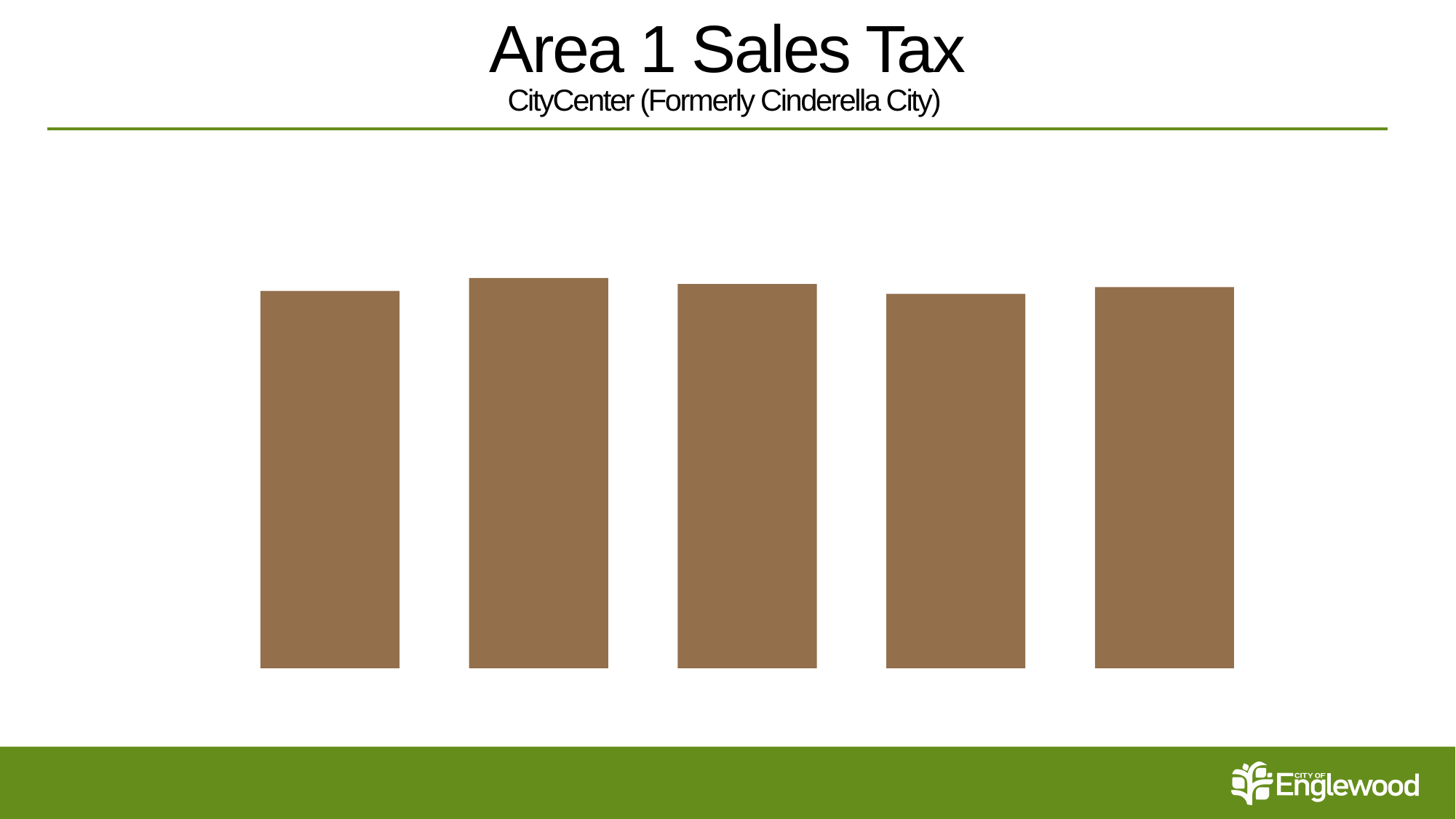
How many bars does the chart show? 5 Which bar is taller, the second bar from the left or the fourth bar from the left? the second bar from the left What colour are the bars in the chart? brown What kind of chart is shown on the slide? bar chart What is the title of the slide containing the chart? Area 1 Sales Tax Which bar is taller, the second bar from the left or the first bar from the left? the second bar from the left